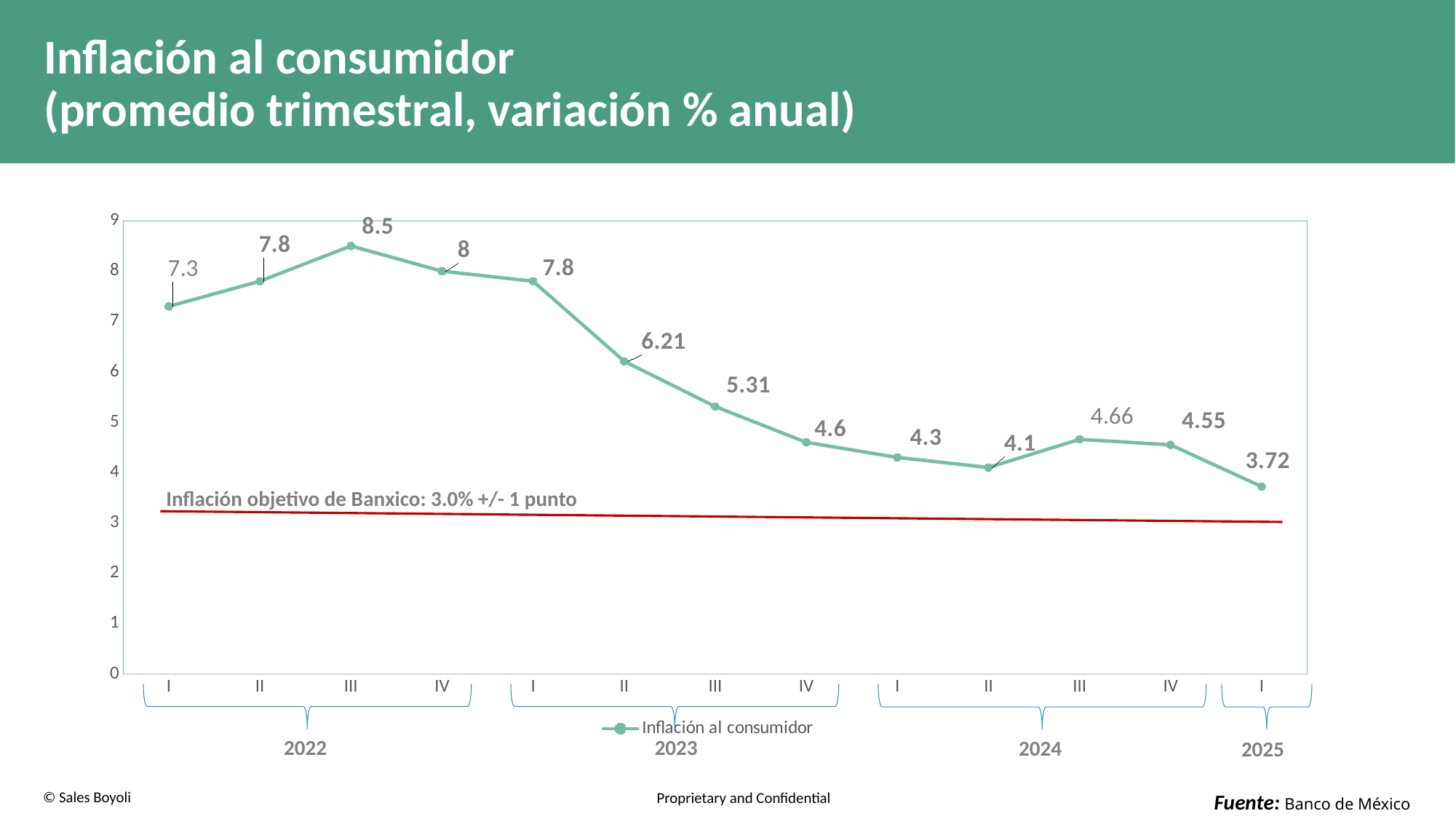
What is the value of Inflación al consumidor for quarter III of 2022? 8.5 What is the difference between the value for quarter III of 2022 and quarter I of 2025? 4.78 Which is larger, the value for quarter III of 2024 or quarter IV of 2024? III 2024 How many series does the legend list? 1 Which quarter has the lowest value of Inflación al consumidor? I 2025 How many data points are plotted for Inflación al consumidor? 13 What target inflation does the red line on the chart represent, according to its label? 3.0% +/- 1 punto What is the value of Inflación al consumidor for quarter I of 2025? 3.72 What is the value of Inflación al consumidor for quarter II of 2023? 6.21 What type of chart is shown on the slide? Line chart Does the value of Inflación al consumidor rise or fall from quarter I of 2023 to quarter IV of 2023? Fall Which quarter has the highest value of Inflación al consumidor? III 2022